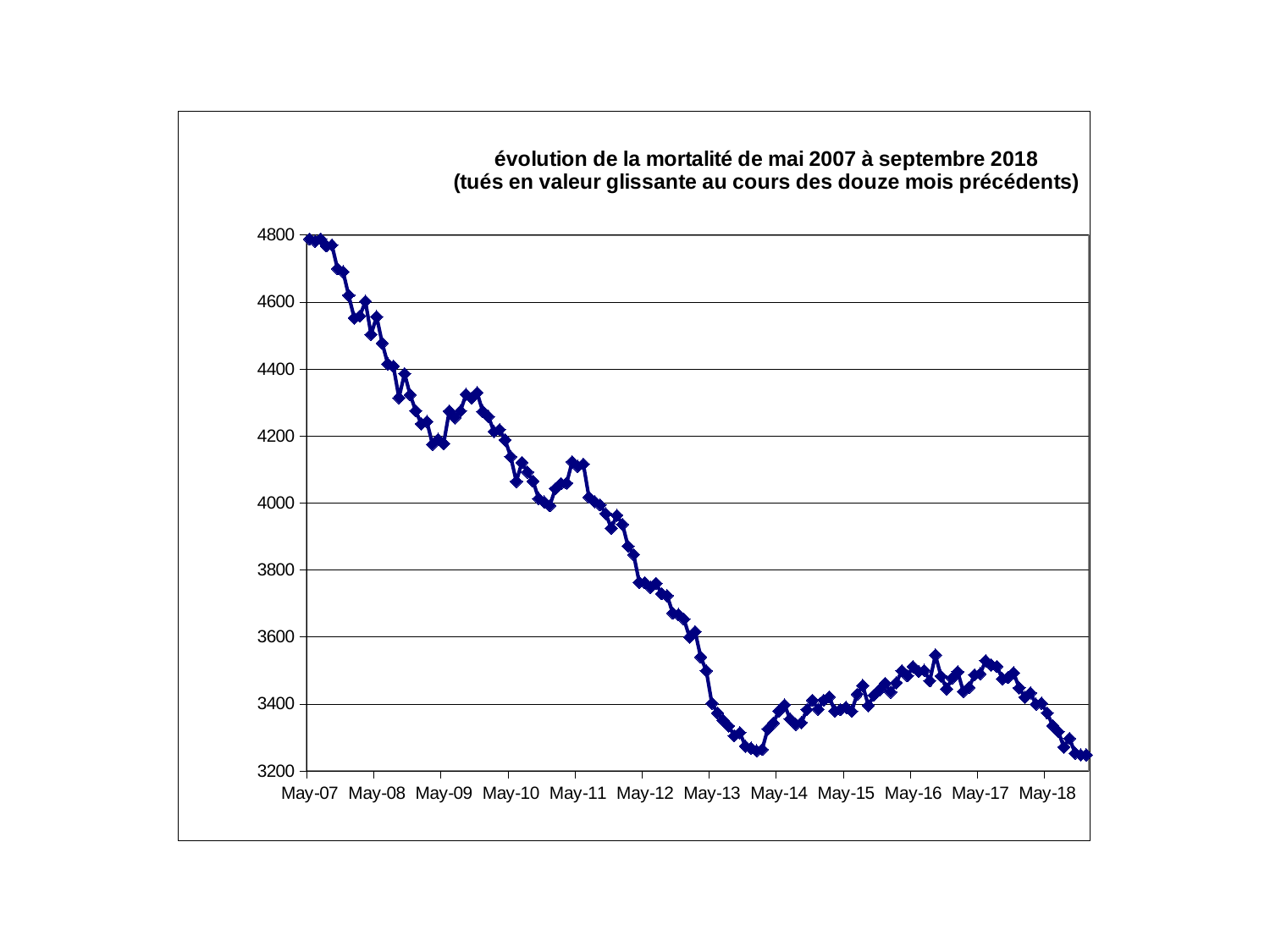
Is the value at May-07 greater or less than 4600? greater Overall, does the line rise or fall from May-07 to May-18? fall How many labels are shown on the x axis? 12 Which is larger, the value at May-11 or the value at May-14? May-11 What is the title of the chart? évolution de la mortalité de mai 2007 à septembre 2018 (tués en valeur glissante au cours des douze mois précédents) Is the value at May-09 greater or less than 4400? less Is the value at May-11 greater or less than 4000? greater Which x-axis label corresponds to the highest point on the line? May-07 What kind of chart is shown on the slide? line chart